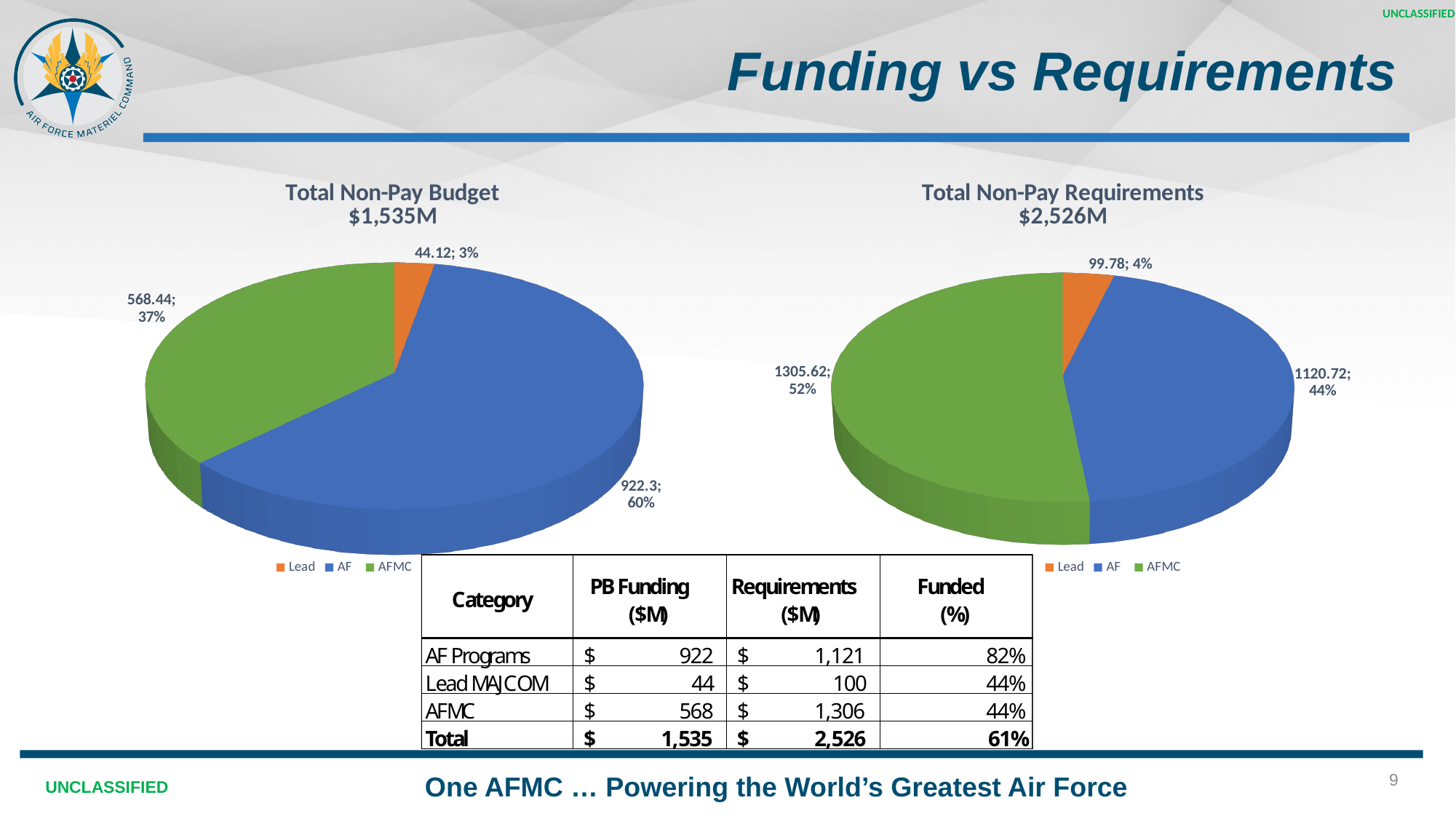
In the Total Non-Pay Requirements pie chart, which category has the smallest slice? Lead In the Total Non-Pay Budget pie chart, what is the difference between the AF value and the AFMC value? 353.86 In the Total Non-Pay Requirements pie chart, what share of the pie does AF represent? 44% How many slices does the Total Non-Pay Requirements pie chart have? 3 In the Total Non-Pay Budget pie chart, what value is shown for the Lead slice? 44.12 In the Total Non-Pay Requirements pie chart, what value is shown for the AFMC slice? 1305.62 In the Total Non-Pay Budget pie chart, what value is shown for the AF slice? 922.3 What type of chart is used for Total Non-Pay Budget? Pie chart In the Total Non-Pay Budget pie chart, what share of the pie does AFMC represent? 37% In the Total Non-Pay Requirements pie chart, what share of the pie does Lead represent? 4% In the Total Non-Pay Budget pie chart, which category has the largest slice? AF In the Total Non-Pay Requirements pie chart, which is larger, the AF slice or the AFMC slice? AFMC